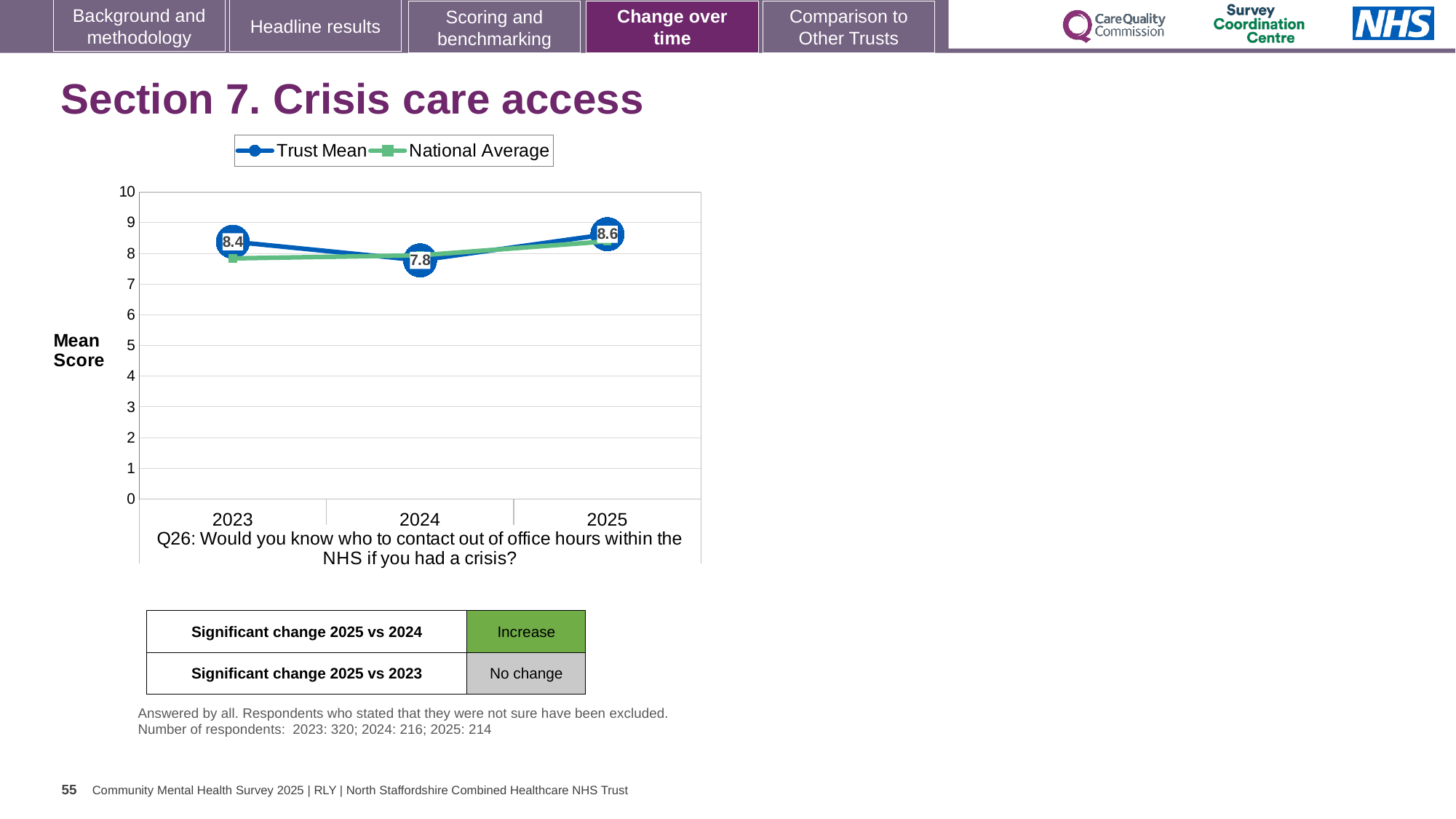
What is the difference between the Trust Mean in 2025 and in 2024? 0.8 How many series does the legend list? 2 In which year is the Trust Mean lowest? 2024 Is the National Average value for 2025 greater or less than 8? greater What is the Trust Mean score for 2023? 8.4 In which year is the Trust Mean highest? 2025 Which is larger, the Trust Mean in 2023 or in 2025? 2025 How many years are plotted on the x axis? 3 Is the National Average value for 2023 greater or less than 8? less What kind of chart is shown on the slide? Line chart What is the Trust Mean score for 2024? 7.8 What is the Trust Mean score for 2025? 8.6